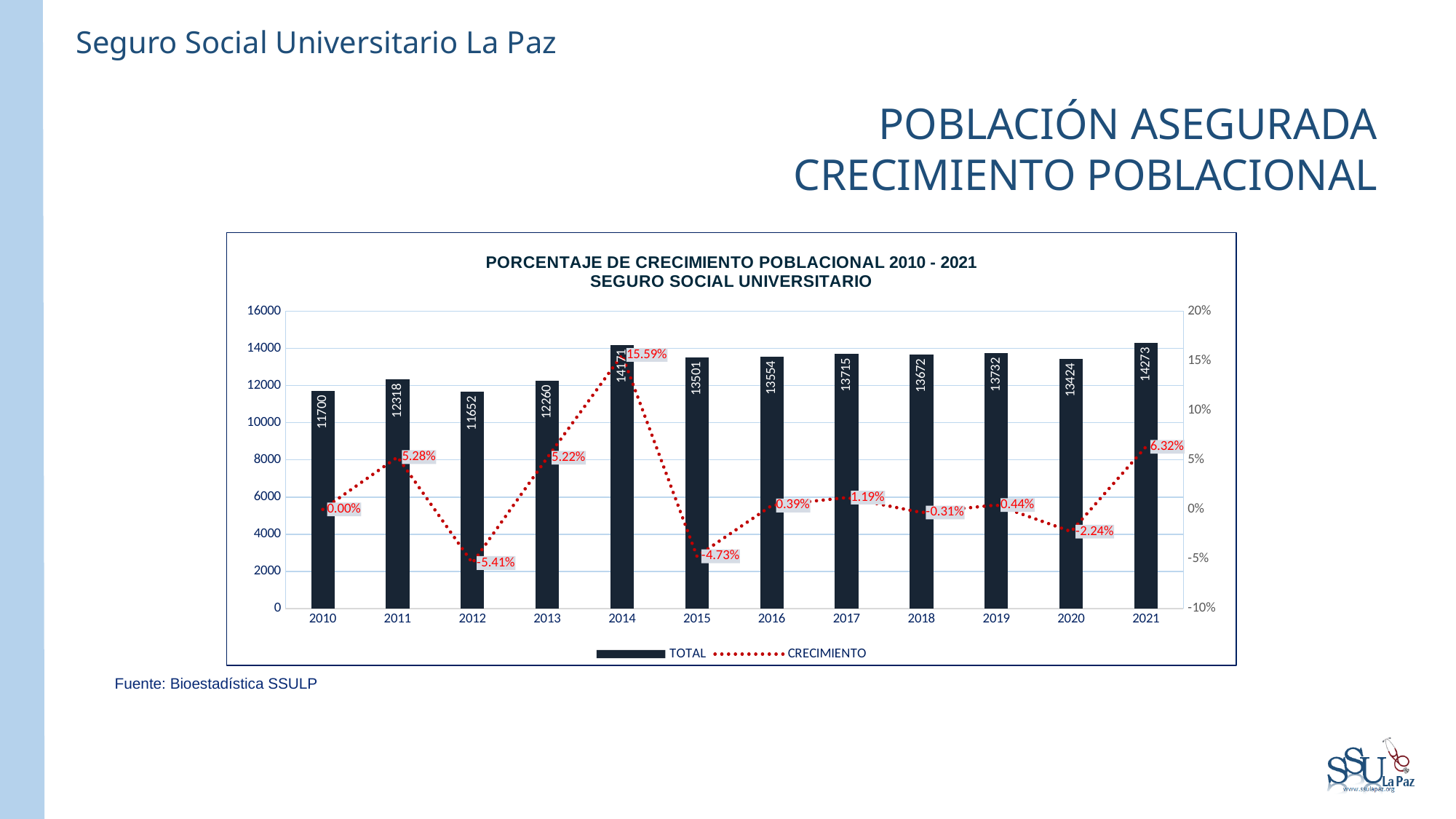
What is the CRECIMIENTO value for 2021? 6.32% Which year has the lowest CRECIMIENTO value? 2012 What is the CRECIMIENTO value for 2012? -5.41% Which year has the highest CRECIMIENTO value? 2014 What is the title of the chart? PORCENTAJE DE CRECIMIENTO POBLACIONAL 2010 - 2021 SEGURO SOCIAL UNIVERSITARIO How many series does the legend list? 2 Which is larger, the TOTAL value for 2015 or for 2016? 2016 What is the difference between the TOTAL values for 2021 and 2020? 849 Which year has the highest TOTAL value? 2021 What is the TOTAL value for 2014? 14171 How many years are shown on the x axis? 12 What is the TOTAL value for 2021? 14273